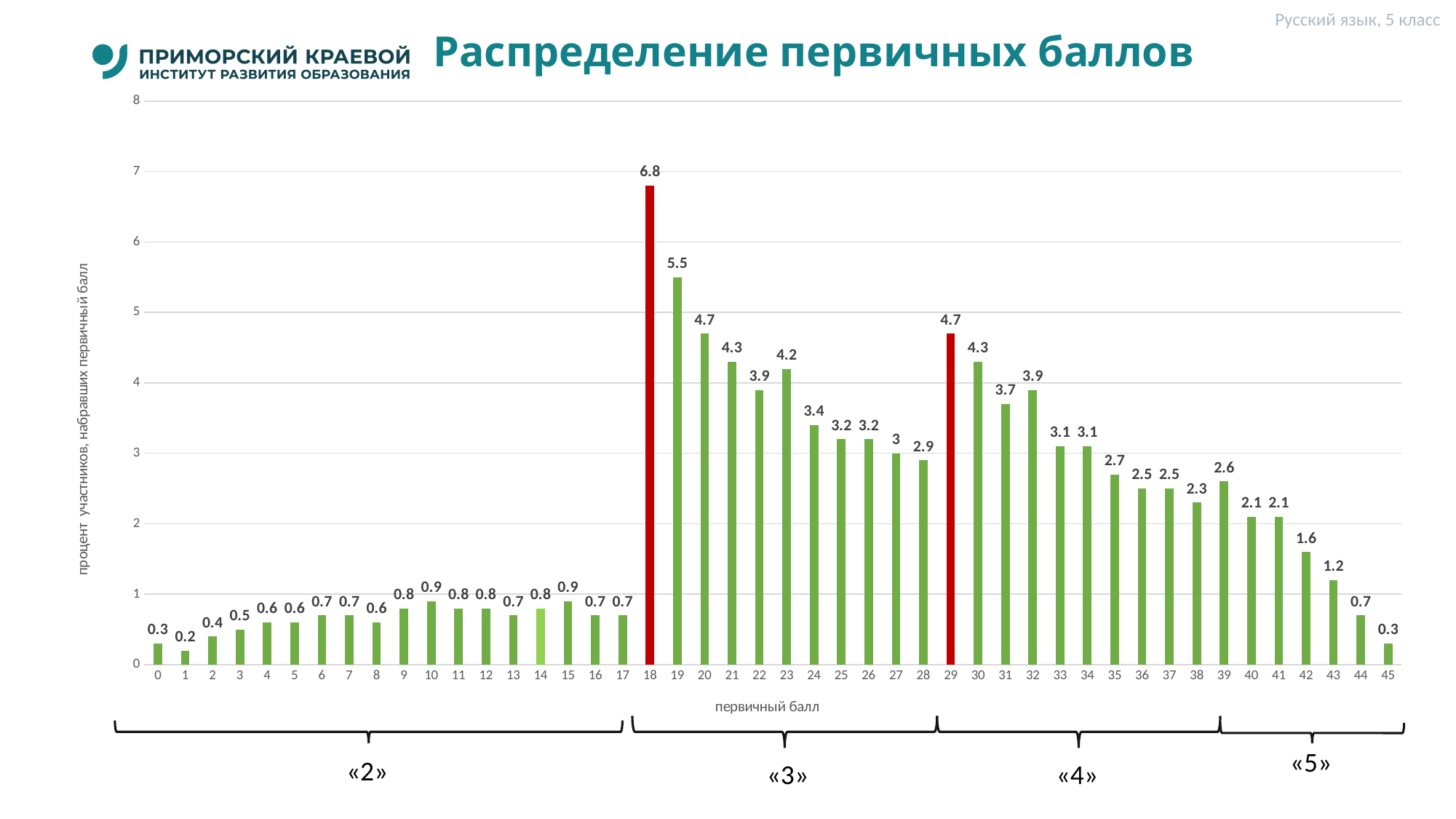
What type of chart is shown on the slide? bar chart What is the value for primary score 18? 6.8 Which primary score has the lowest value? 1 What is the value for primary score 43? 1.2 Do the values rise or fall from primary score 29 to primary score 45? fall Which primary score has the highest value? 18 What colour are the bars for primary scores 18 and 29? red Is the value for primary score 20 greater or less than 4? greater What is the difference between the values for primary scores 18 and 19? 1.3 Which is larger, the value for primary score 31 or for primary score 32? 32 What is the value for primary score 29? 4.7 How many primary score categories are shown on the x axis? 46